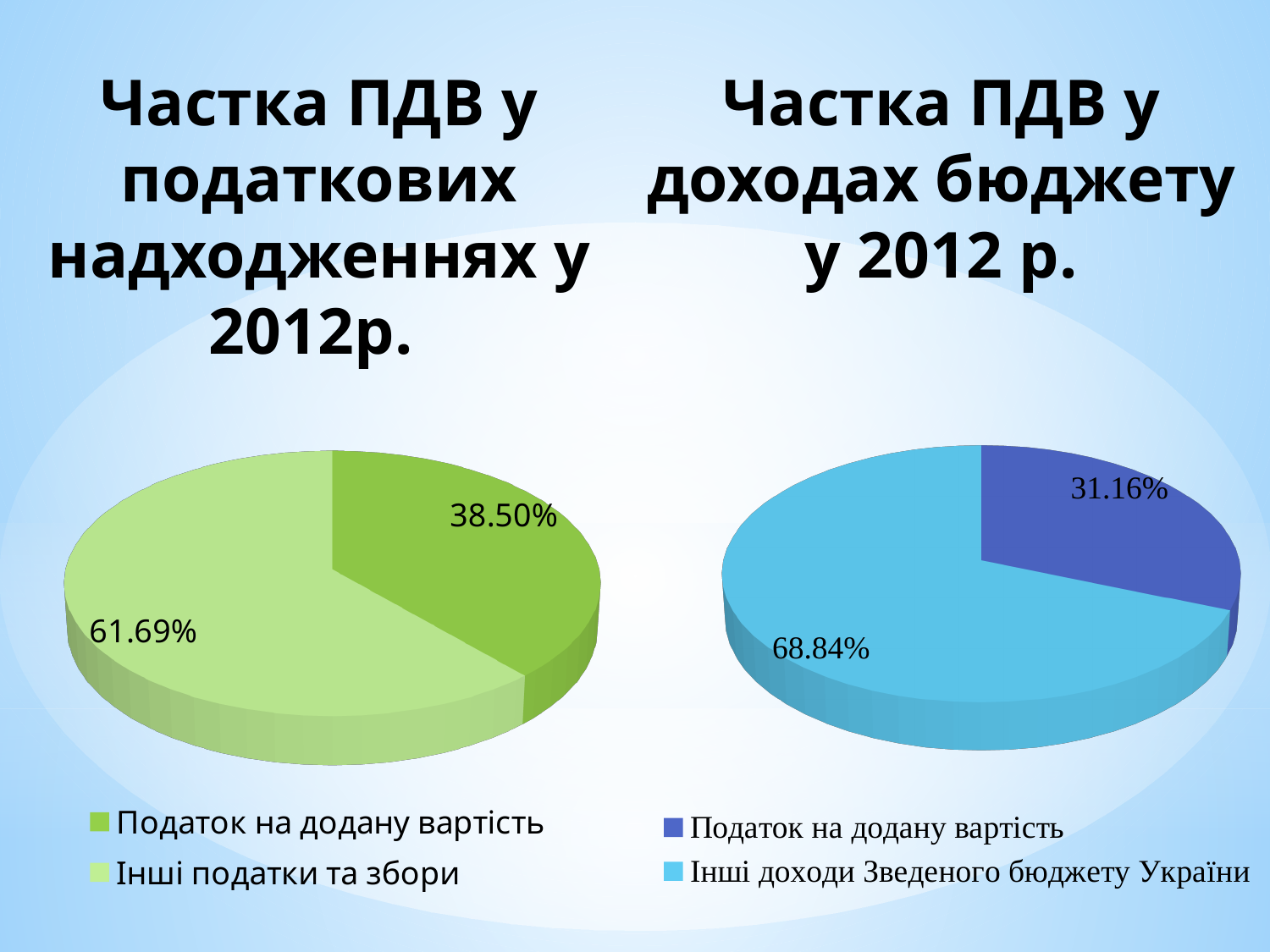
In the right chart (Частка ПДВ у доходах бюджету у 2012 р.), which slice is the smallest? Податок на додану вартість In the right chart (Частка ПДВ у доходах бюджету у 2012 р.), what is the difference in percentage points between Інші доходи Зведеного бюджету України and Податок на додану вартість? 37.68 In the left chart (Частка ПДВ у податкових надходженнях у 2012р.), which slice is the largest? Інші податки та збори What type of chart is used on the right side of the slide (Частка ПДВ у доходах бюджету у 2012 р.)? Pie chart In the left chart (Частка ПДВ у податкових надходженнях у 2012р.), what is the difference in percentage points between Інші податки та збори and Податок на додану вартість? 23.19 How many slices does the left chart (Частка ПДВ у податкових надходженнях у 2012р.) have? 2 In the right chart (Частка ПДВ у доходах бюджету у 2012 р.), what share does Податок на додану вартість have? 31.16% In the left chart (Частка ПДВ у податкових надходженнях у 2012р.), what share does Інші податки та збори have? 61.69% In the left chart (Частка ПДВ у податкових надходженнях у 2012р.), what share does Податок на додану вартість have? 38.50% How many entries does the legend of the right chart (Частка ПДВ у доходах бюджету у 2012 р.) list? 2 Which is larger: the share of Податок на додану вартість in the left chart or in the right chart? Left chart (38.50%)